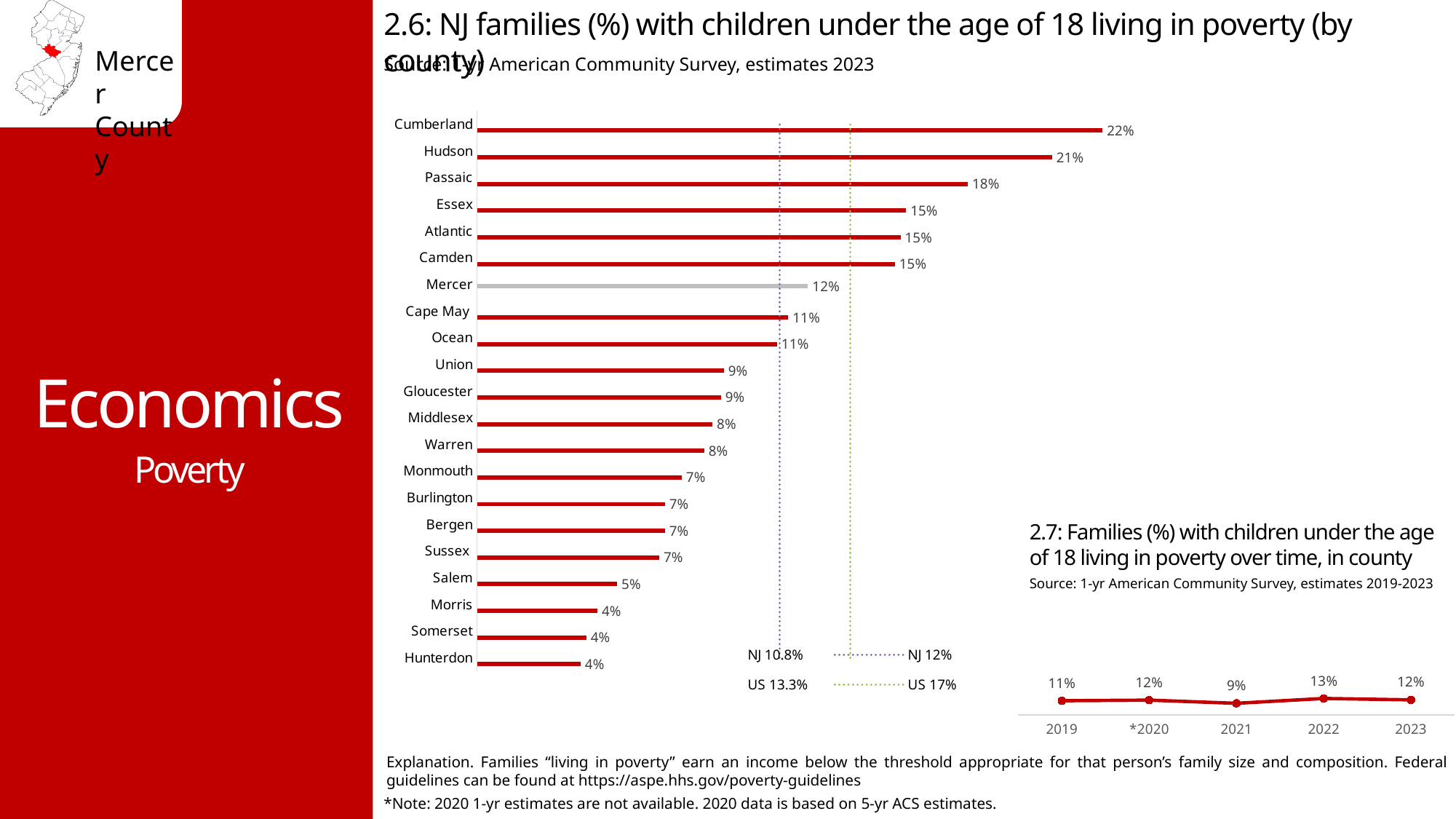
In chart 2.7, what is the difference between the 2022 and 2021 values? 4% What kind of chart is chart 2.6? Bar chart In chart 2.7, how many years are plotted? 5 In chart 2.6, what is the difference between the values for Hudson and Passaic? 3% In chart 2.6, what percentage of families with children under 18 live in poverty in Cumberland? 22% In chart 2.7, which year has the lowest value? 2021 In chart 2.6, which county has the highest percentage of families with children living in poverty? Cumberland In chart 2.7, what was the percentage of families with children living in poverty in 2022? 13% In chart 2.6, which has a higher value, Essex or Union? Essex In chart 2.6, what is the value shown for Mercer? 12% In chart 2.6, how many counties are plotted? 21